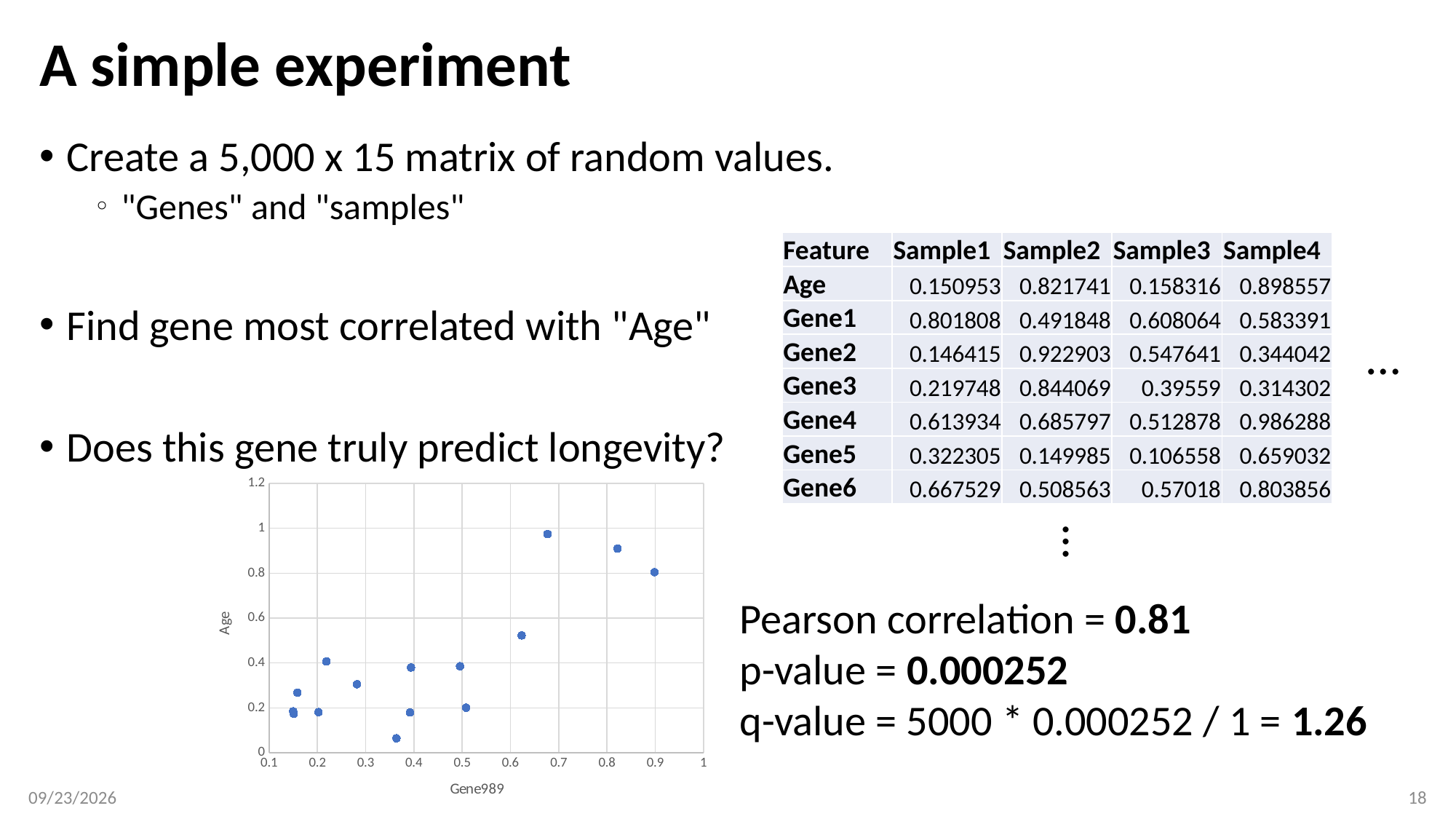
Is the Age value of the point with the smallest Gene989 value greater or less than 0.4? less Is the Age value of the lowest point in the scatter chart greater or less than 0.2? less What is the maximum value shown on the y axis of the scatter chart? 1.2 What kind of chart is shown on the slide? scatter chart Is the Age value of the point with the largest Gene989 value greater or less than 0.6? greater Do the Age values in the scatter chart generally rise or fall as Gene989 increases? rise How many data points are plotted in the scatter chart? 15 What is the label of the y axis of the scatter chart? Age What is the label of the x axis of the scatter chart? Gene989